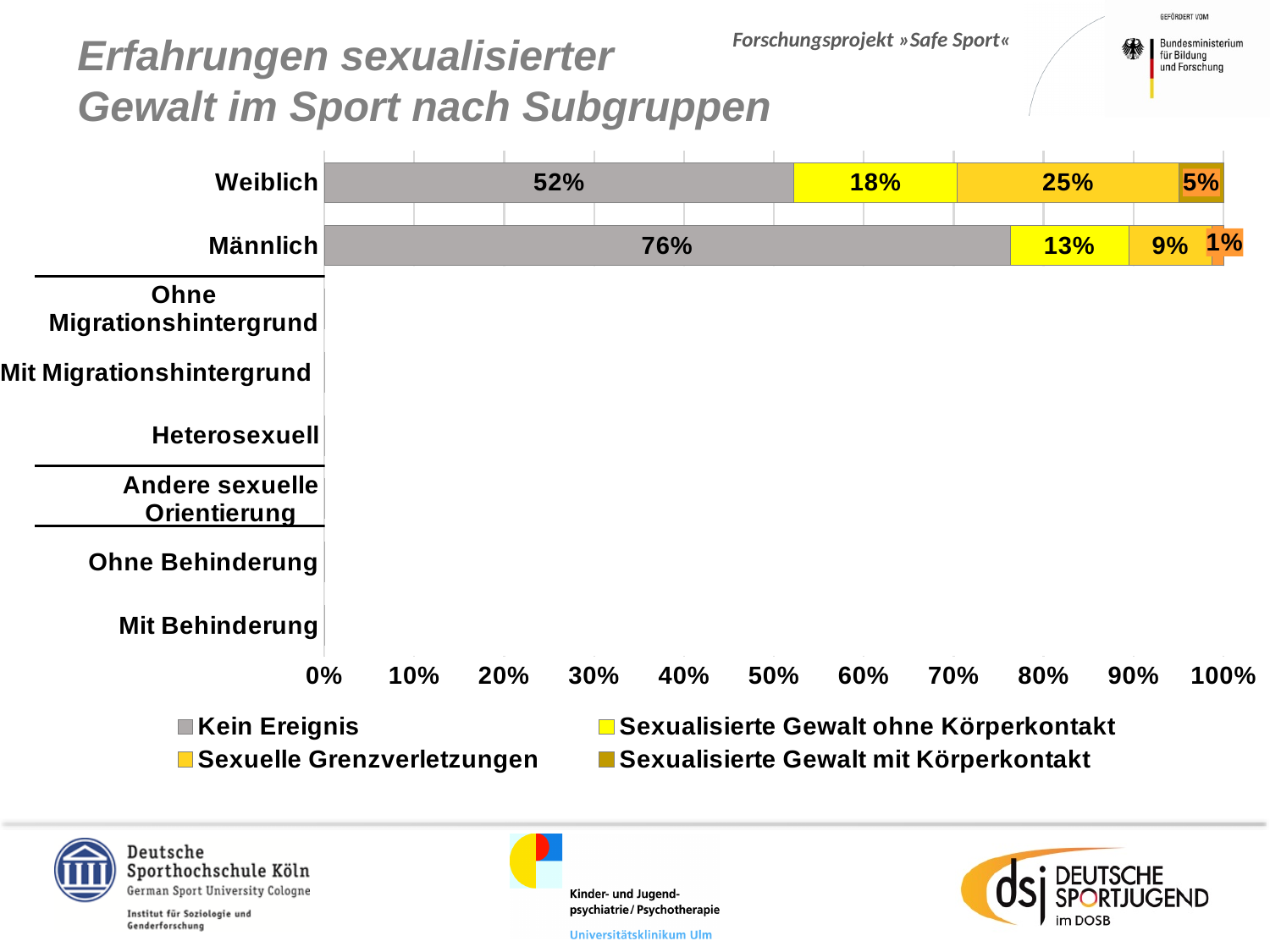
What is the total of the segments in the Weiblich bar? 100% What is the difference in percentage points between the "Kein Ereignis" values for Männlich and Weiblich? 24 percentage points How many subgroup categories are listed on the vertical axis? 8 Which legend entry is shown in grey? Kein Ereignis What is the value of "Kein Ereignis" for the Weiblich group? 52% What is the value of the last (rightmost) segment of the Männlich bar? 1% How many series does the legend list? 4 What is the value of the last (rightmost) segment of the Weiblich bar? 5% Is the "Kein Ereignis" value for Weiblich greater or less than 50%? greater Which group has the higher "Kein Ereignis" share, Weiblich or Männlich? Männlich What kind of chart is shown on the slide? Stacked bar chart What is the value of "Kein Ereignis" for the Männlich group? 76%